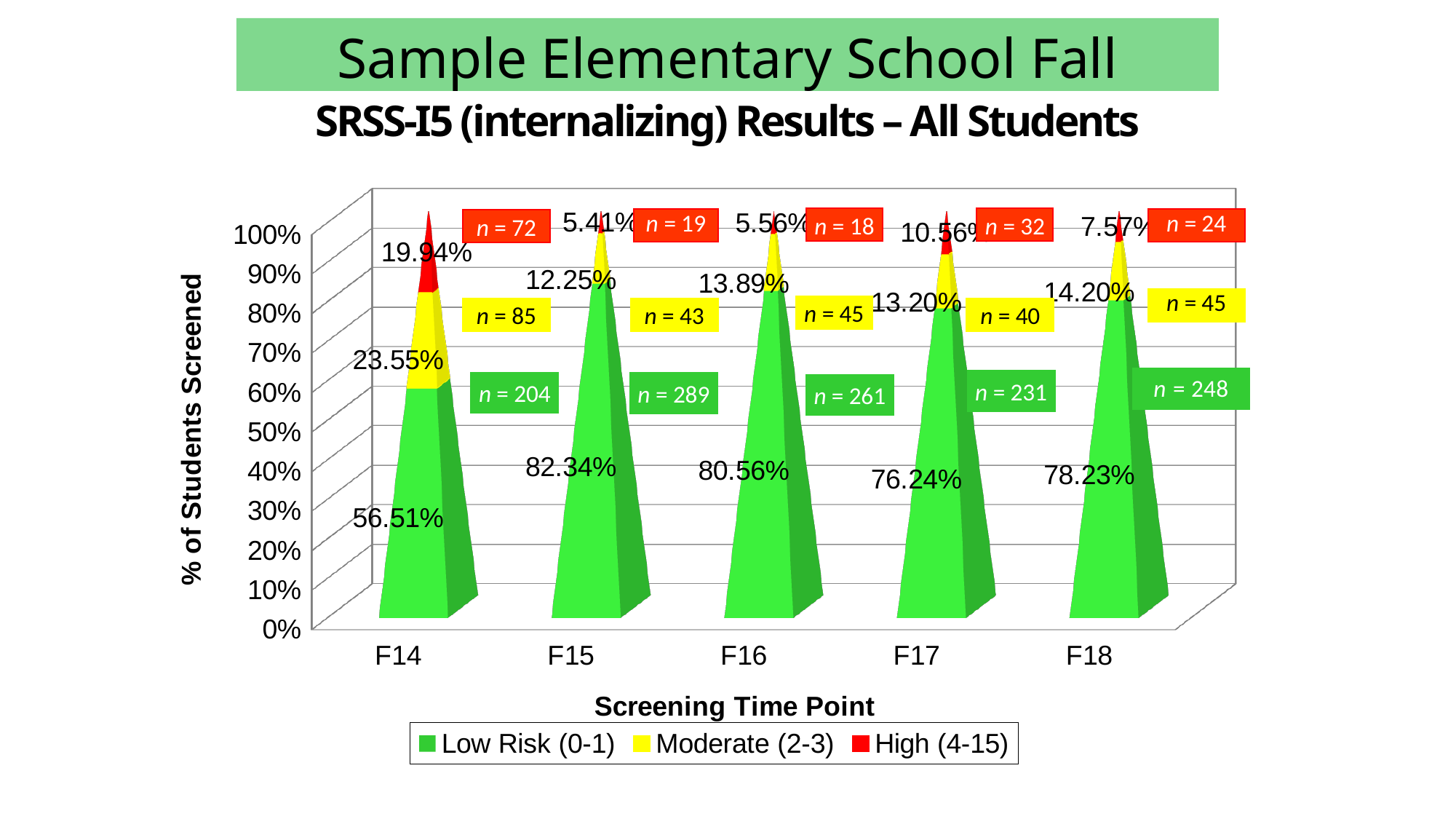
What is the Low Risk (0-1) percentage at F14? 56.51% What is the High (4-15) percentage at F17? 10.56% What is the difference between the Low Risk percentages at F15 and F14? 25.83% Which is larger, the Moderate (2-3) percentage at F16 or at F17? F16 How many series does the legend list? 3 Which screening time point has the highest Low Risk (0-1) percentage? F15 What is the Moderate (2-3) percentage at F18? 14.20% How many screening time points are shown on the x axis? 5 Which screening time point has the lowest High (4-15) percentage? F15 What is the label of the y axis? % of Students Screened What kind of chart is shown? Stacked bar chart What is the n value shown for the Low Risk group at F15? n = 289